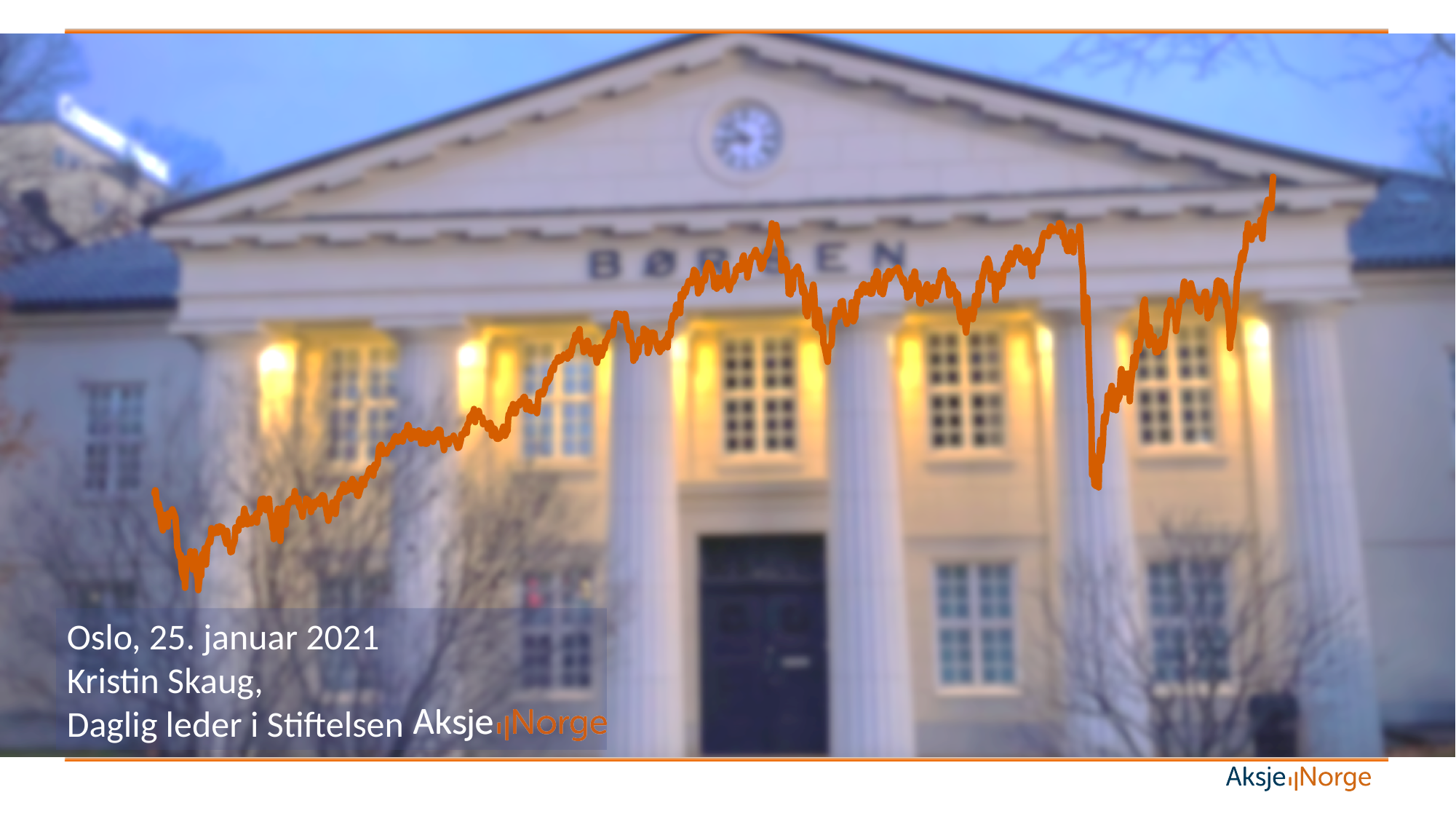
Does the plotted line generally rise or fall from left to right across the slide? rise How many lines are plotted on the chart? 1 What kind of chart is overlaid on the photograph of the stock exchange building? line chart Does the chart show any axis labels or data labels? no What colour is the plotted line on the chart? orange